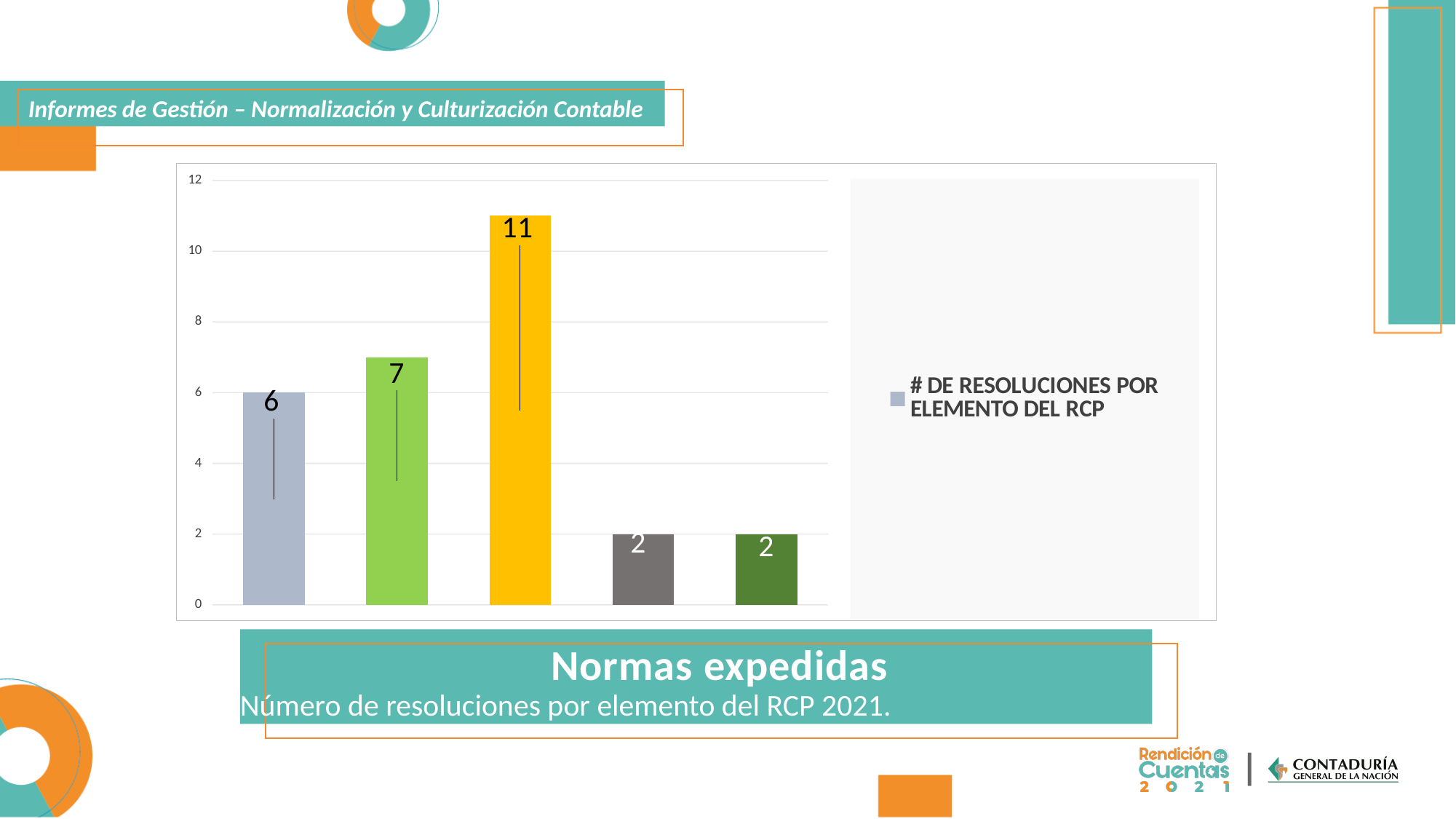
What is the value of the second (light green) bar in the chart? 7 Which is larger, the value of the first bar or the value of the second bar? the second bar What is the lowest value shown among the bars? 2 How many bars are plotted in the chart? 5 How many series does the chart legend list? 1 What type of chart is shown on the slide? bar chart What series name is shown in the chart legend? # DE RESOLUCIONES POR ELEMENTO DEL RCP What is the value of the fourth (grey) bar in the chart? 2 What is the difference between the value of the third (yellow) bar and the second (light green) bar? 4 What is the highest value shown among the bars? 11 What is the value of the first (light blue-grey) bar in the chart? 6 What is the value of the tallest (yellow, third) bar in the chart? 11